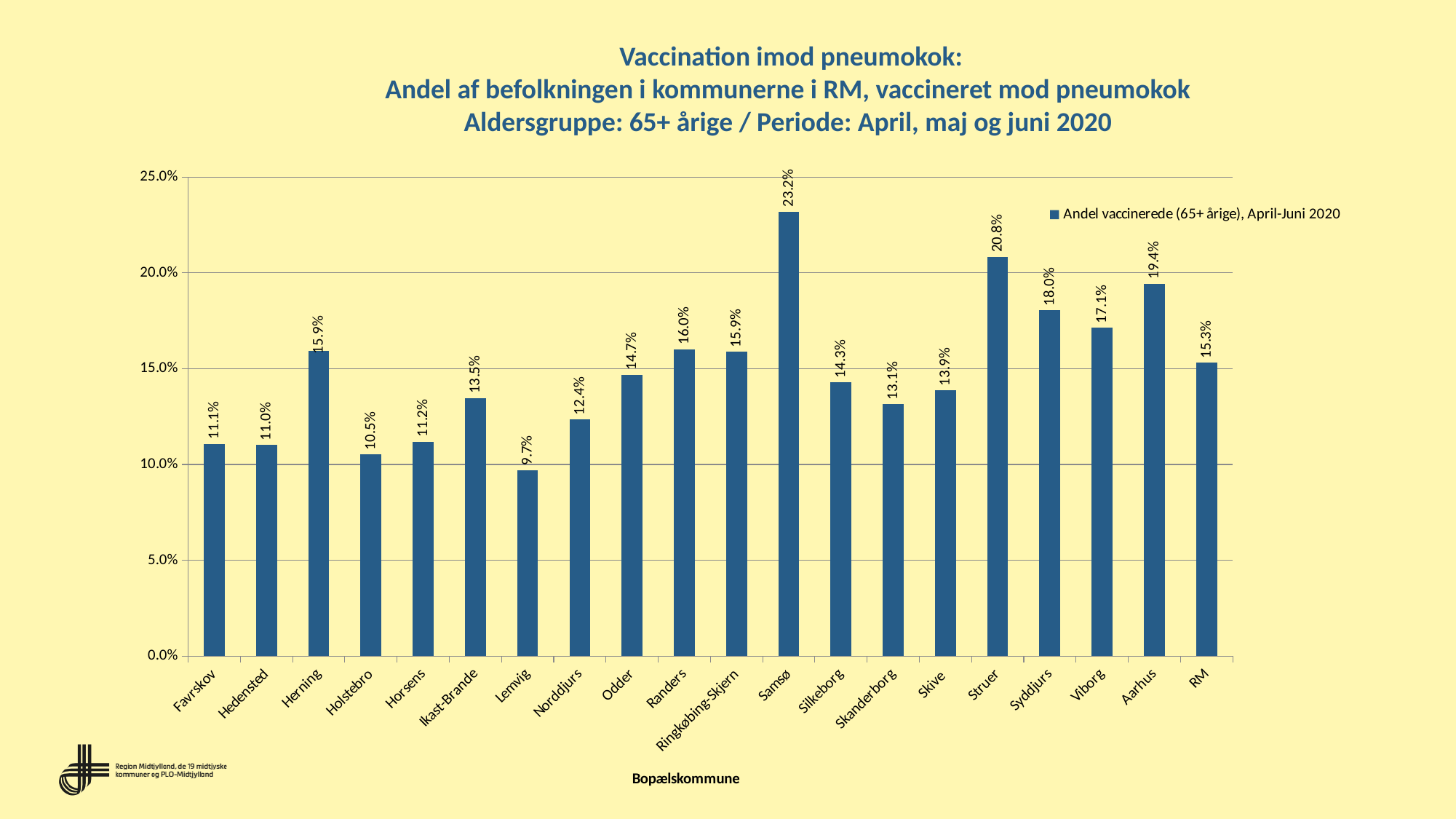
Which municipality has the lowest share of vaccinated 65+ year olds? Lemvig Which municipality has the highest share of vaccinated 65+ year olds? Samsø What is the value for RM? 15.3% What kind of chart is shown on the slide? bar chart What is the value for Lemvig? 9.7% How many categories are shown on the x axis? 20 Is the value for Syddjurs greater or less than 15.0%? greater What is the difference between the values for Struer and Aarhus? 1.4% Which is larger, the value for Herning or the value for Viborg? Viborg What is the label of the x axis? Bopælskommune What is the value for Samsø? 23.2% How many series does the legend list? 1